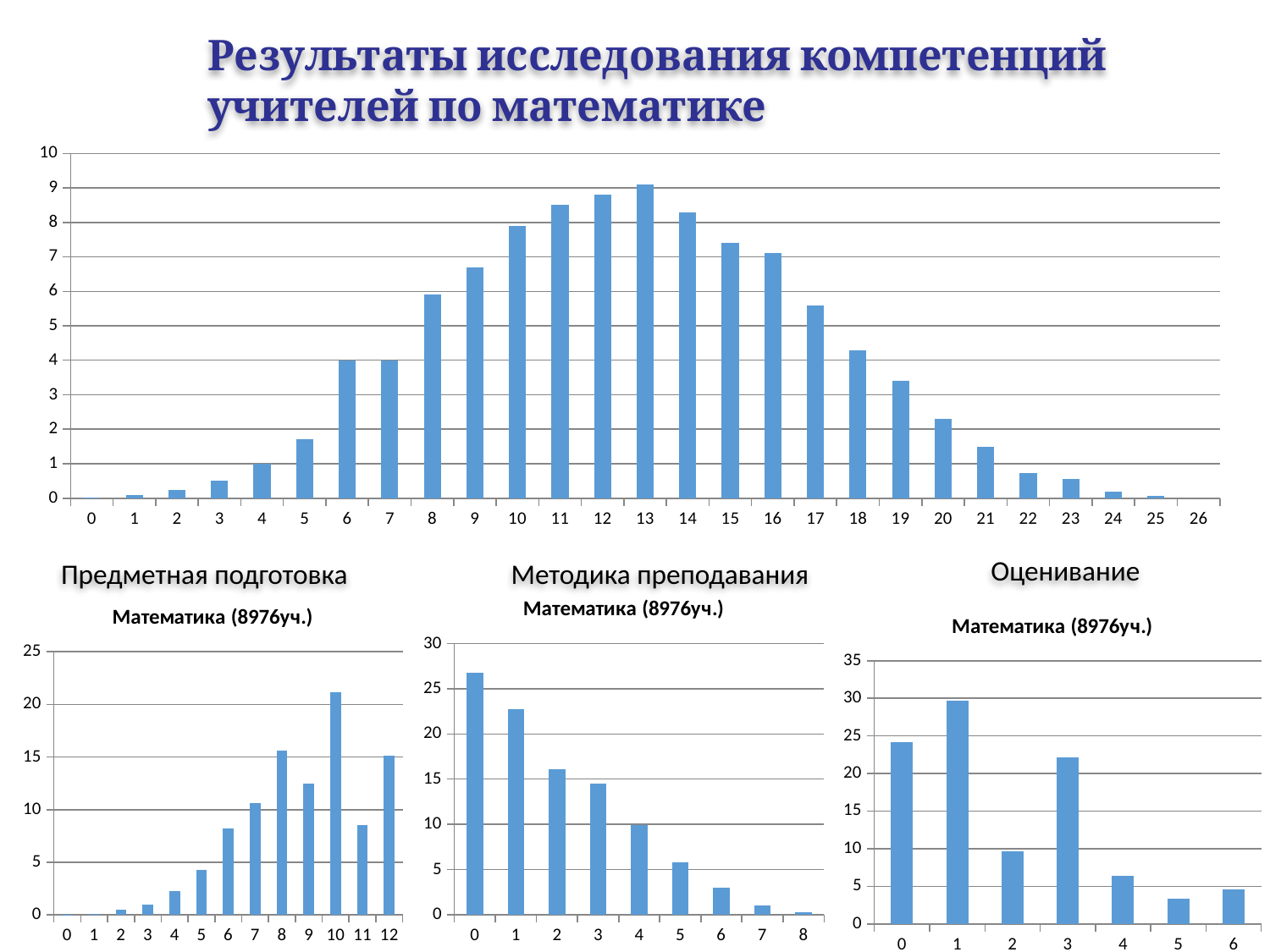
In the large chart at the top of the slide, is the value for category 20 greater or less than 3? less In the 'Оценивание' chart, which is larger, the value for category 5 or the value for category 6? 6 In the large chart at the top of the slide, how many categories are shown on the x axis? 27 In the 'Оценивание' chart, which category has the highest bar? 1 In the 'Предметная подготовка' chart, is the value for category 10 greater or less than 20? greater What kind of chart is the large chart at the top of the slide? bar chart In the 'Методика преподавания' chart, how many categories are shown on the x axis? 9 In the large chart at the top of the slide, which category has the highest bar? 13 In the 'Методика преподавания' chart, do the values generally rise or fall as the category number increases? fall In the large chart at the top of the slide, is the value for category 10 greater or less than 7? greater In the 'Предметная подготовка' chart, which category has the highest bar? 10